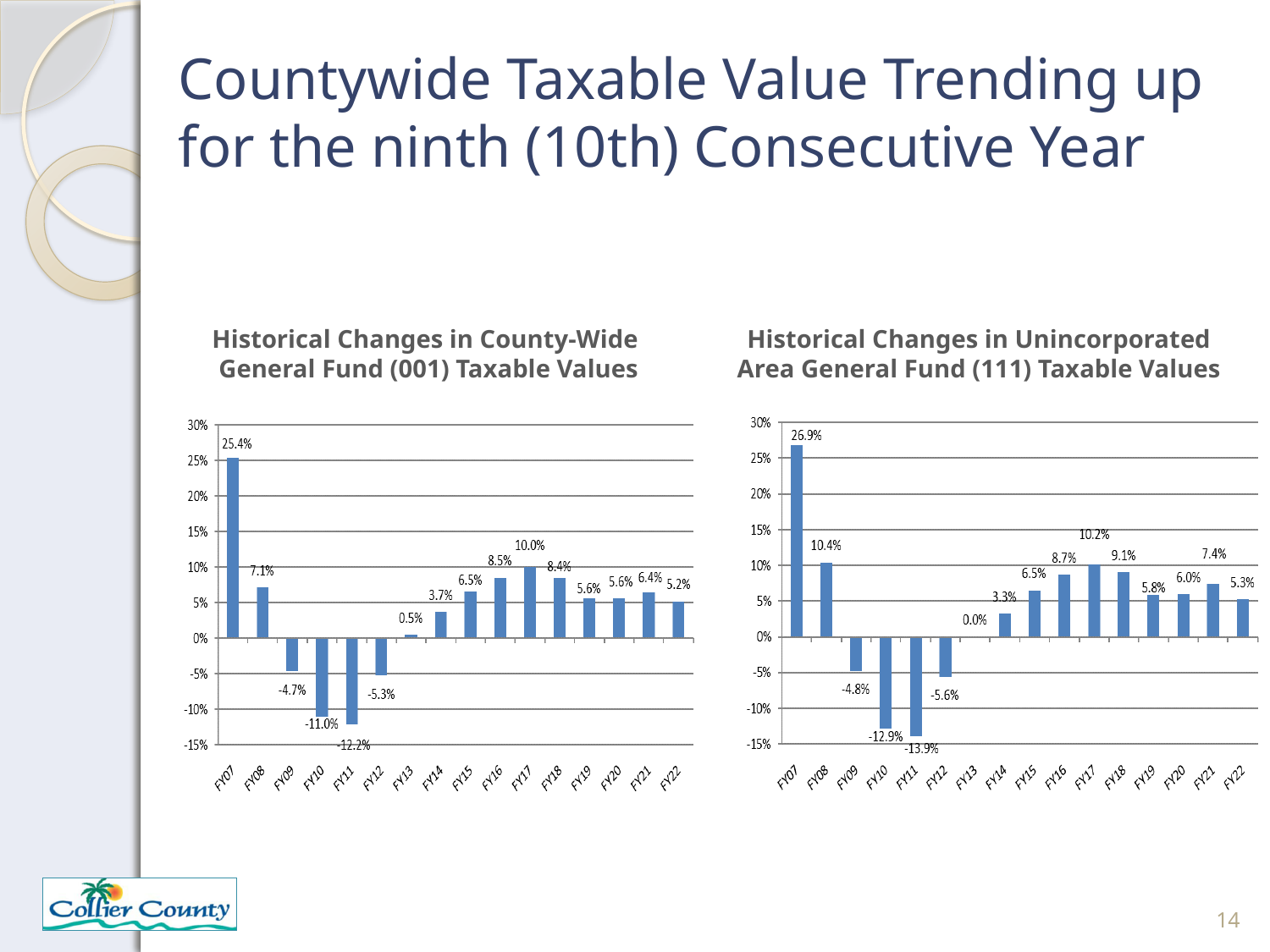
In the 'Historical Changes in Unincorporated Area General Fund (111) Taxable Values' chart, what is the value for FY17? 10.2% In the 'Historical Changes in County-Wide General Fund (001) Taxable Values' chart, do the values rise or fall from FY11 to FY17? Rise In the 'Historical Changes in Unincorporated Area General Fund (111) Taxable Values' chart, what is the value for FY13? 0.0% What is the title of the chart on the left side of the slide? Historical Changes in County-Wide General Fund (001) Taxable Values In the 'Historical Changes in County-Wide General Fund (001) Taxable Values' chart, what is the difference between the FY17 value and the FY22 value? 4.8% How many fiscal years are shown on the x axis of the 'Historical Changes in County-Wide General Fund (001) Taxable Values' chart? 16 In the 'Historical Changes in County-Wide General Fund (001) Taxable Values' chart, what is the value for FY07? 25.4% What kind of chart is the 'Historical Changes in Unincorporated Area General Fund (111) Taxable Values' chart? Bar chart In the 'Historical Changes in County-Wide General Fund (001) Taxable Values' chart, which fiscal year has the lowest value? FY11 In the 'Historical Changes in Unincorporated Area General Fund (111) Taxable Values' chart, what is the difference between the FY10 value and the FY11 value? 1.0% In the 'Historical Changes in Unincorporated Area General Fund (111) Taxable Values' chart, which is larger, the value for FY16 or the value for FY18? FY18 In the 'Historical Changes in Unincorporated Area General Fund (111) Taxable Values' chart, which fiscal year has the highest value? FY07